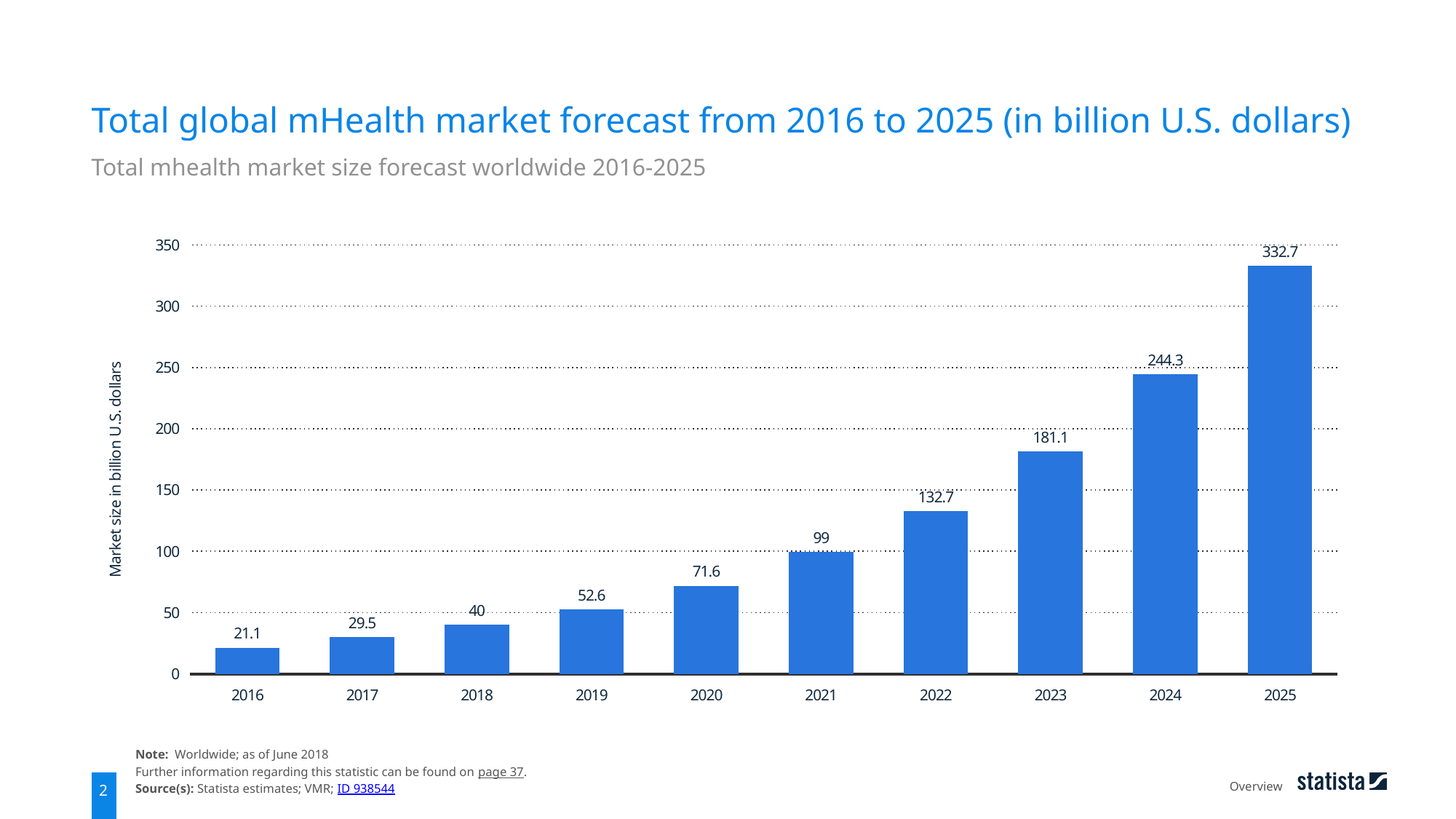
How many years are shown on the x axis? 10 Which year has the lowest forecast market size? 2016 Do the values rise or fall from 2016 to 2025? Rise What is the difference between the 2025 and 2024 forecast values? 88.4 What is the forecast mHealth market size for 2018? 40 Which year has the highest forecast market size? 2025 Which year has a larger forecast value, 2021 or 2022? 2022 What is the label of the y axis? Market size in billion U.S. dollars What kind of chart is shown on the slide? Bar chart Is the value for 2023 greater or less than 200? less What is the forecast mHealth market size for 2025? 332.7 What is the forecast mHealth market size for 2020? 71.6